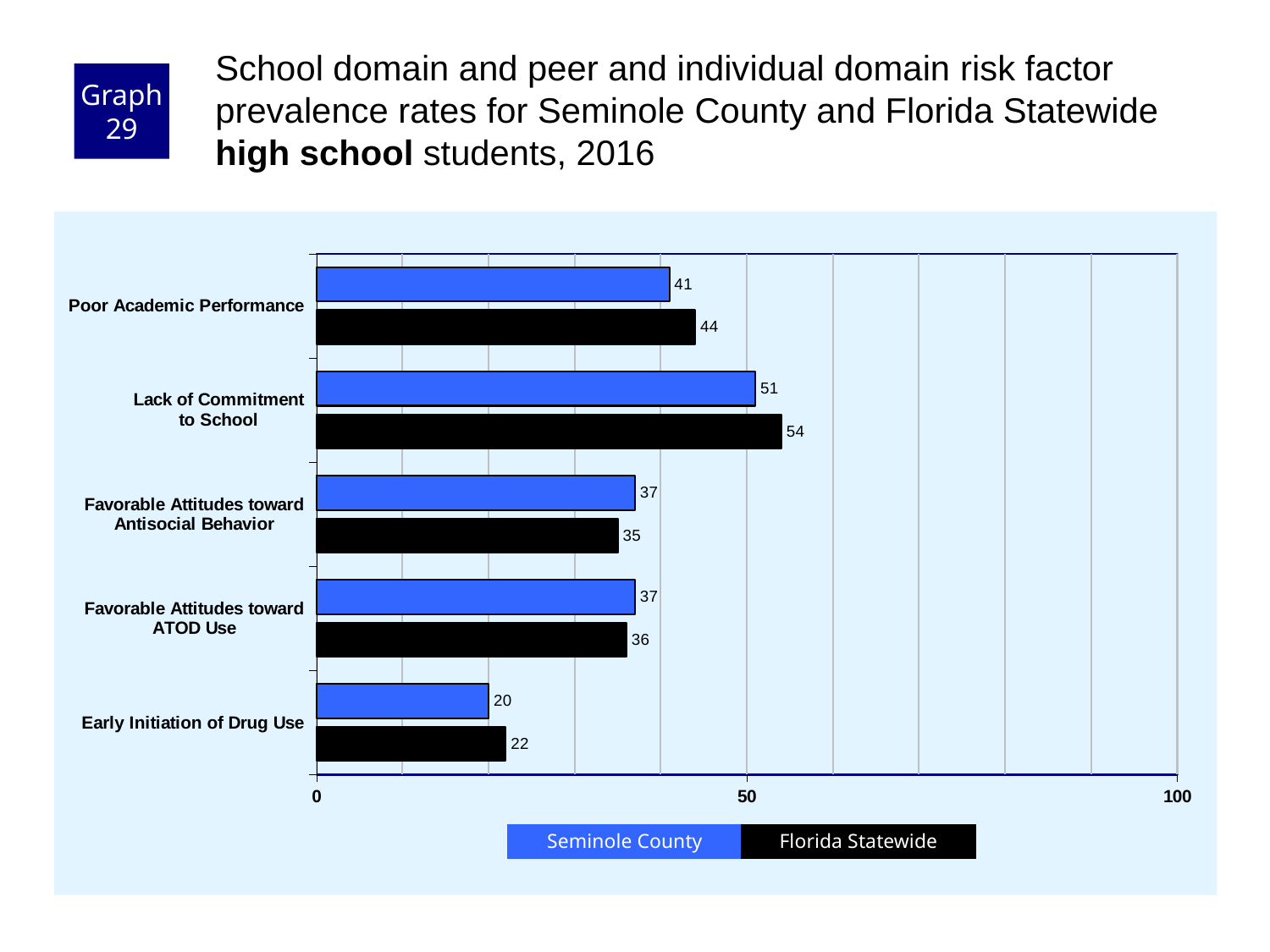
What is the difference between the Florida Statewide and Seminole County values for Poor Academic Performance? 3 Which risk factor has the highest Seminole County value? Lack of Commitment to School What is the Seminole County value for Poor Academic Performance? 41 Is the Florida Statewide value for Lack of Commitment to School greater or less than 50? greater For Favorable Attitudes toward ATOD Use, which is larger: the Seminole County value or the Florida Statewide value? Seminole County What is the Seminole County value for Early Initiation of Drug Use? 20 What is the Florida Statewide value for Favorable Attitudes toward Antisocial Behavior? 35 Which risk factor has the lowest Florida Statewide value? Early Initiation of Drug Use What is the Florida Statewide value for Lack of Commitment to School? 54 How many series does the legend list? 2 How many risk factor categories are shown on the chart? 5 What kind of chart is shown on the slide? Bar chart